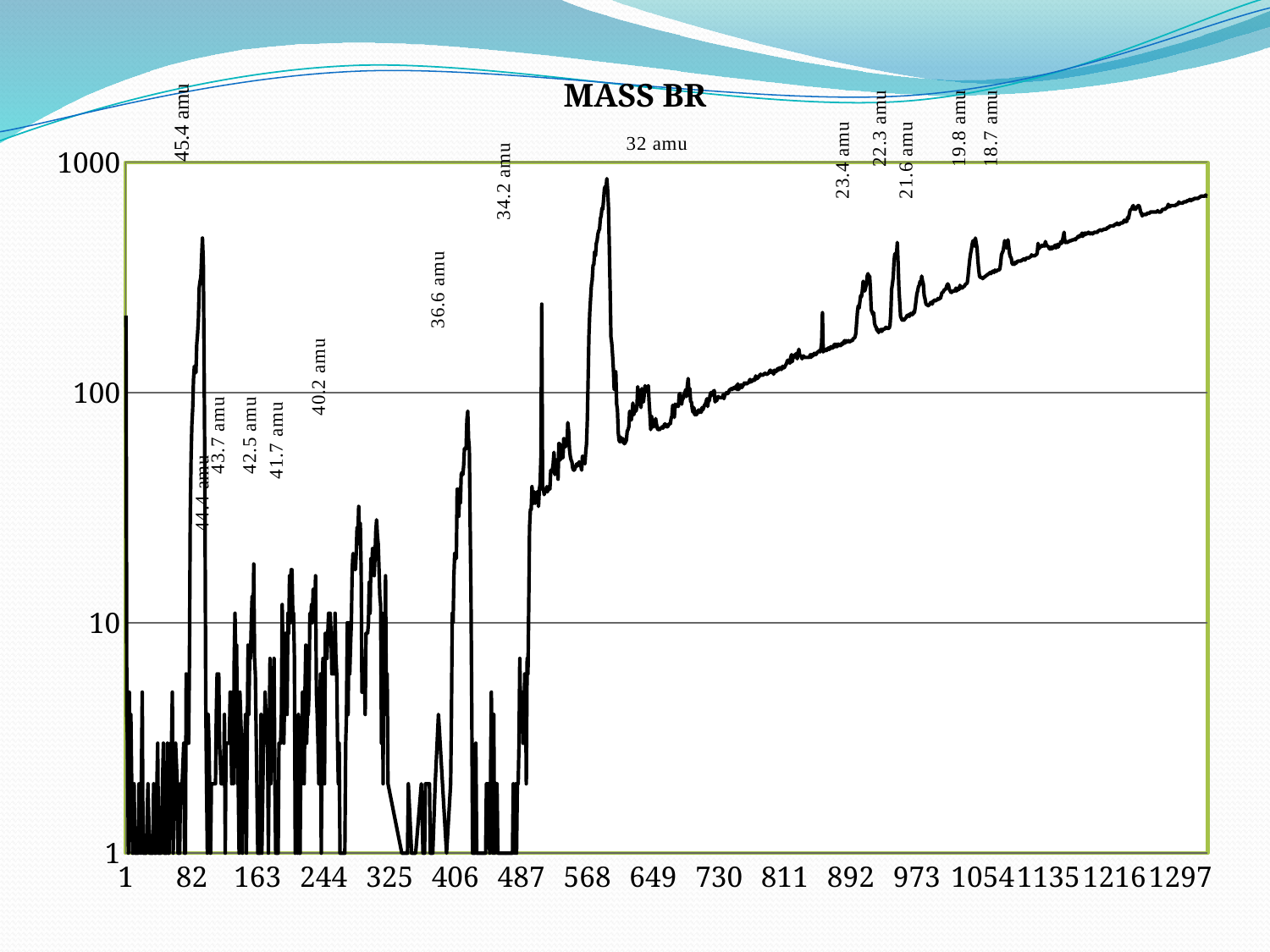
Is the peak labelled "32 amu" greater or less than 100? greater From x = 730 to x = 1297, does the line generally rise or fall? rise Which is higher, the peak labelled "32 amu" or the peak labelled "45.4 amu"? 32 amu What is the title of the chart? MASS BR Is the peak labelled "36.6 amu" greater or less than 100? less What kind of chart is shown on the slide? line chart Is the value at the right end of the line (x = 1297) greater or less than 100? greater How many "amu" annotation labels are placed on the chart? 14